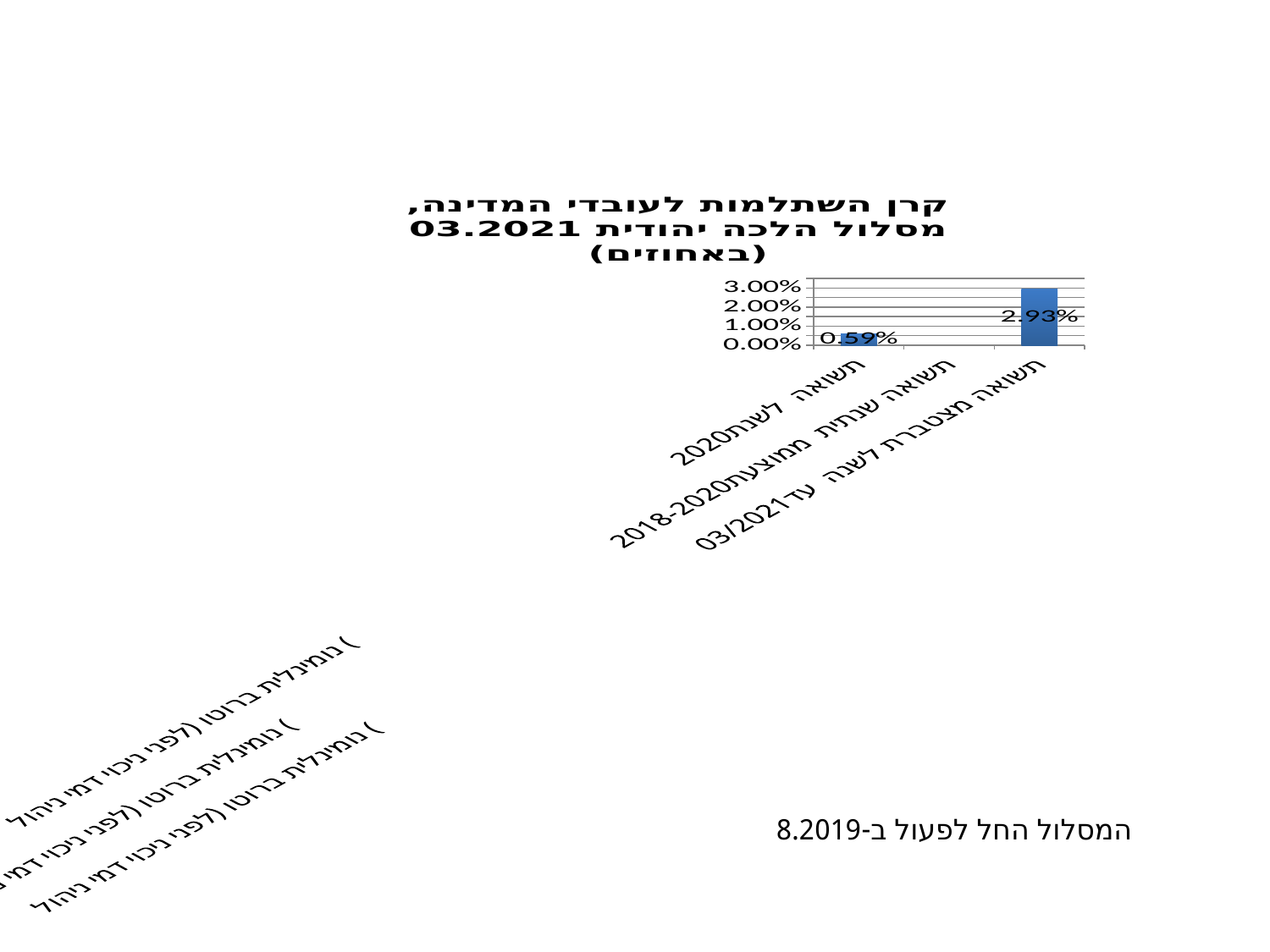
What type of chart is shown on the slide? bar chart What is the highest value shown on the y axis of the chart? 3.00% Is the value for תשואה לשנת 2020 greater or less than 1.00%? less What is the title of the chart? קרן השתלמות לעובדי המדינה, מסלול הלכה יהודית 03.2021 (באחוזים) Is the value for תשואה מצטברת לשנה עד 03/2021 greater or less than 2.00%? greater Which is larger: the value for תשואה לשנת 2020 or the value for תשואה מצטברת לשנה עד 03/2021? תשואה מצטברת לשנה עד 03/2021 How many categories are shown on the x axis of the chart? 3 What is the value for תשואה מצטברת לשנה עד 03/2021? 2.93% Which category has the highest value? תשואה מצטברת לשנה עד 03/2021 What is the value for תשואה לשנת 2020? 0.59% What is the difference between the value for תשואה מצטברת לשנה עד 03/2021 and the value for תשואה לשנת 2020? 2.34%